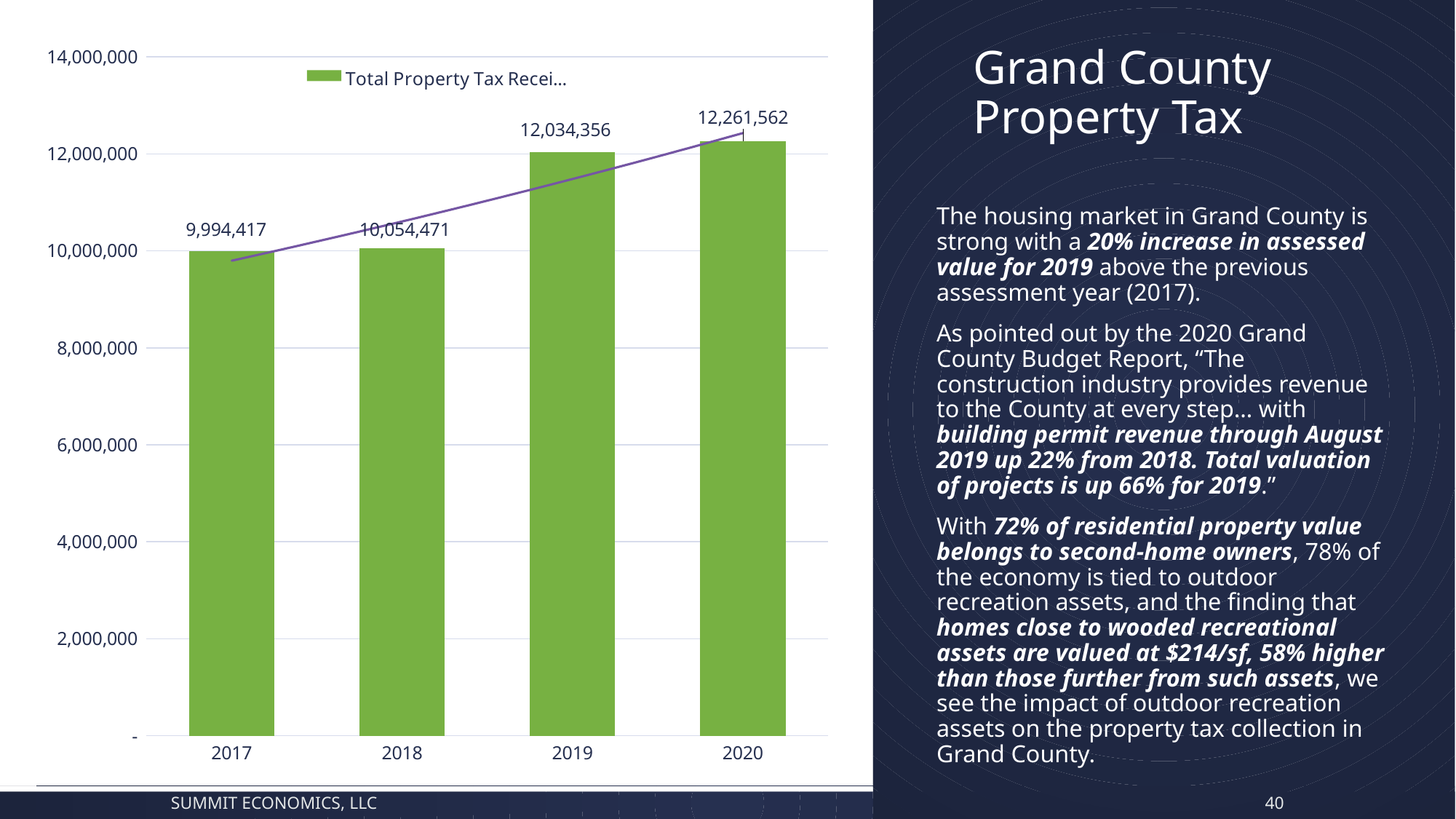
What is the value for 2020? 12,261,562 What kind of chart is shown on the slide? bar chart What is the value for 2019? 12,034,356 Which year has the highest value? 2020 Do the values rise or fall from 2017 to 2020? rise How many years are shown on the x axis? 4 What is the difference between the values for 2020 and 2019? 227,206 Which is larger, the value for 2018 or the value for 2017? 2018 What is the difference between the values for 2019 and 2018? 1,979,885 Which year has the lowest value? 2017 Is the value for 2018 greater or less than 12,000,000? less What is the value for 2017? 9,994,417